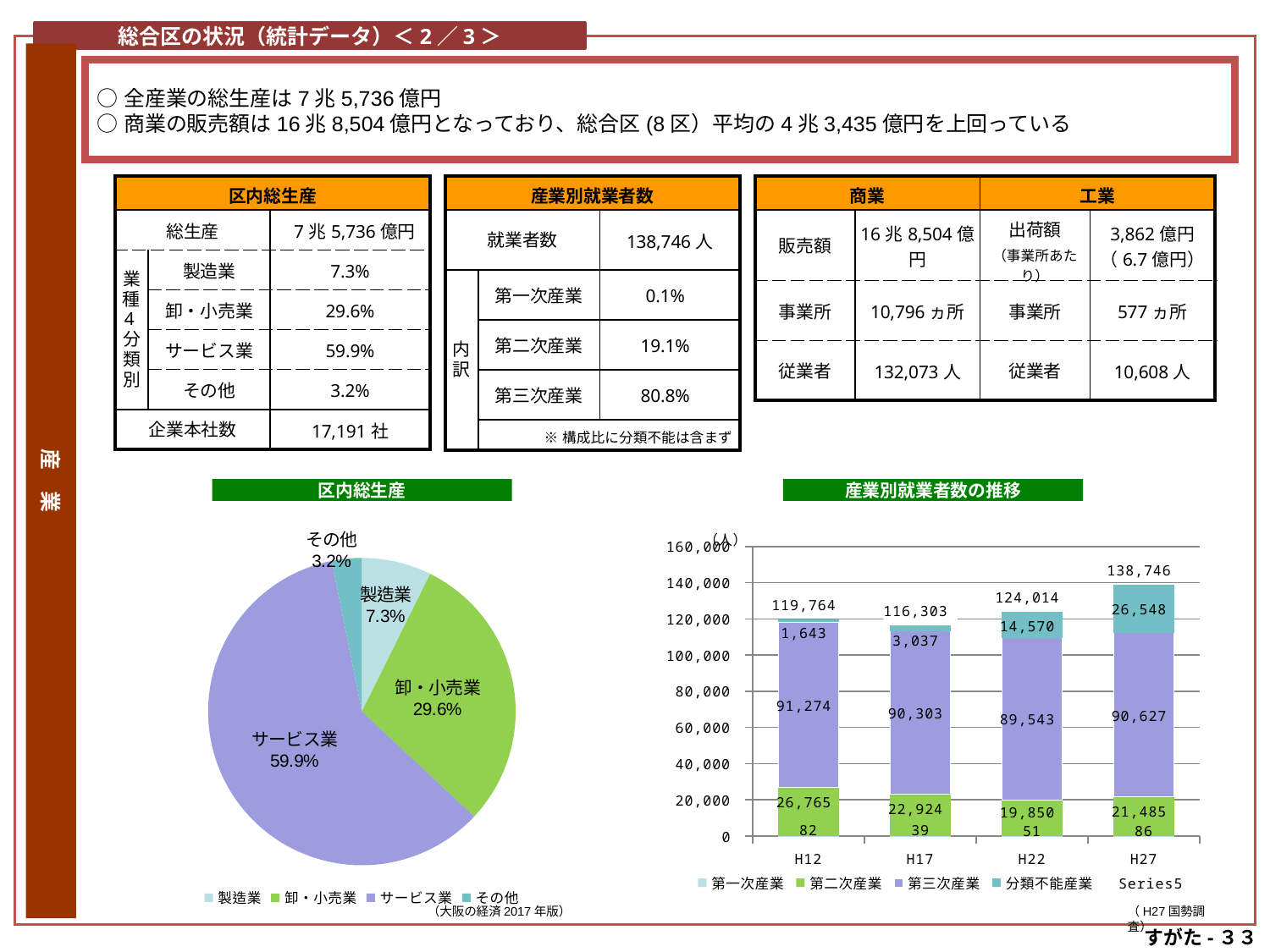
In the 産業別就業者数の推移 chart, how many entries does the legend list? 5 In the 区内総生産 pie chart, how many slices are there? 4 In the 産業別就業者数の推移 chart, what is the difference between the 分類不能産業 values for H27 and H22? 11,978 In the 産業別就業者数の推移 chart, what is the value for 第三次産業 in H22? 89,543 What kind of chart is the 区内総生産 chart? Pie chart In the 産業別就業者数の推移 chart, which year has the lowest total? H17 In the 産業別就業者数の推移 chart, is the total for H12 greater or less than 100,000? greater In the 区内総生産 pie chart, which is larger, 製造業 or 卸・小売業? 卸・小売業 What kind of chart is the 産業別就業者数の推移 chart? Stacked bar chart In the 区内総生産 pie chart, which category has the smallest share? その他 In the 産業別就業者数の推移 chart, what is the total of the H27 bar? 138,746 In the 区内総生産 pie chart, what share does サービス業 have? 59.9%